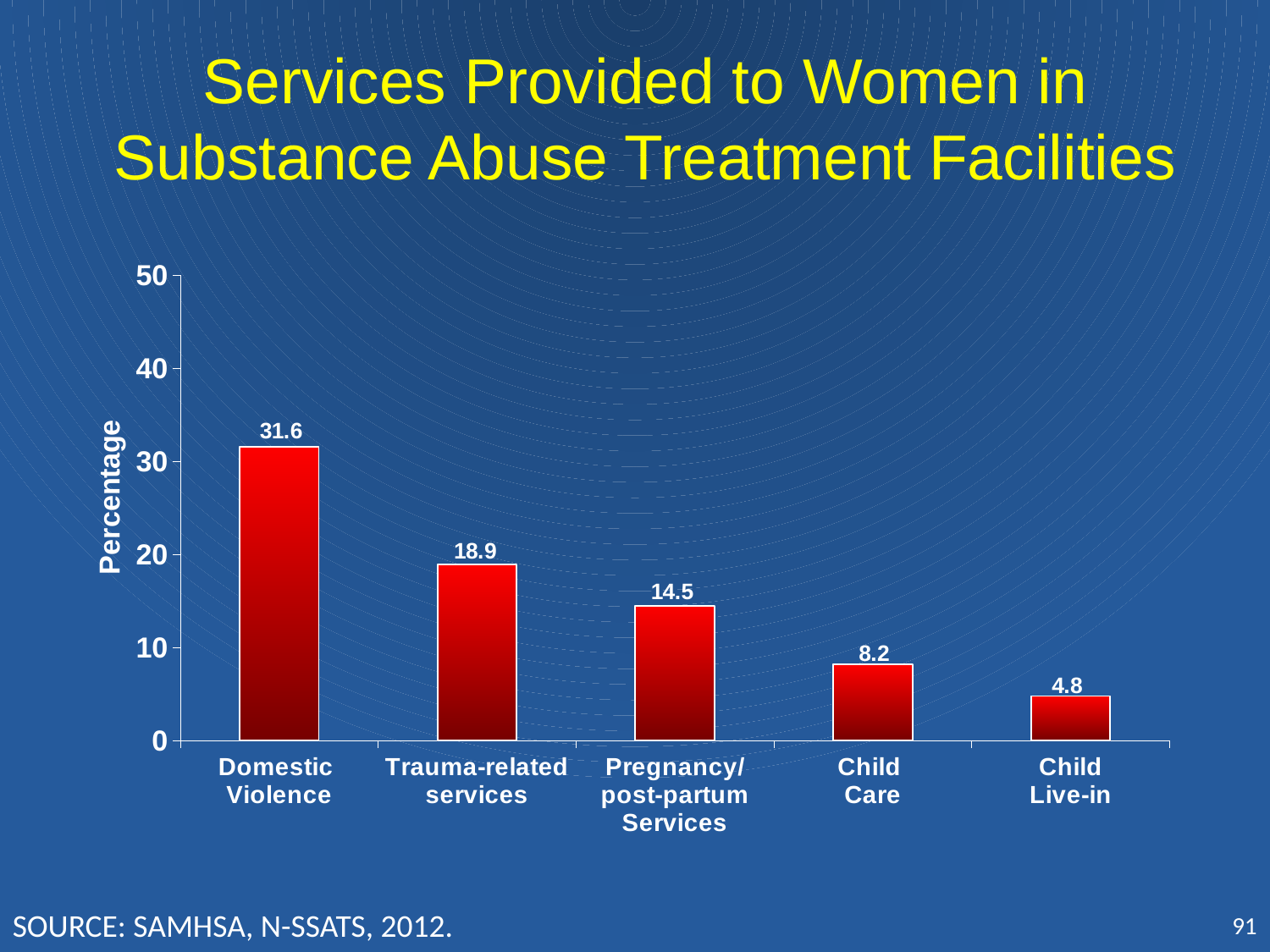
Which service has the highest percentage? Domestic Violence How many service categories are shown in the chart? 5 What is the difference between the Domestic Violence and Trauma-related services values? 12.7 What percentage of facilities provide Domestic Violence services? 31.6 Which service has the lowest percentage? Child Live-in Which is larger, the value for Pregnancy/post-partum Services or Child Care? Pregnancy/post-partum Services What is the value for Trauma-related services? 18.9 What is the difference between the Child Care and Child Live-in values? 3.4 What is the value for Pregnancy/post-partum Services? 14.5 What is the value for Child Live-in? 4.8 What kind of chart is shown on the slide? Bar chart What is the label of the y axis? Percentage